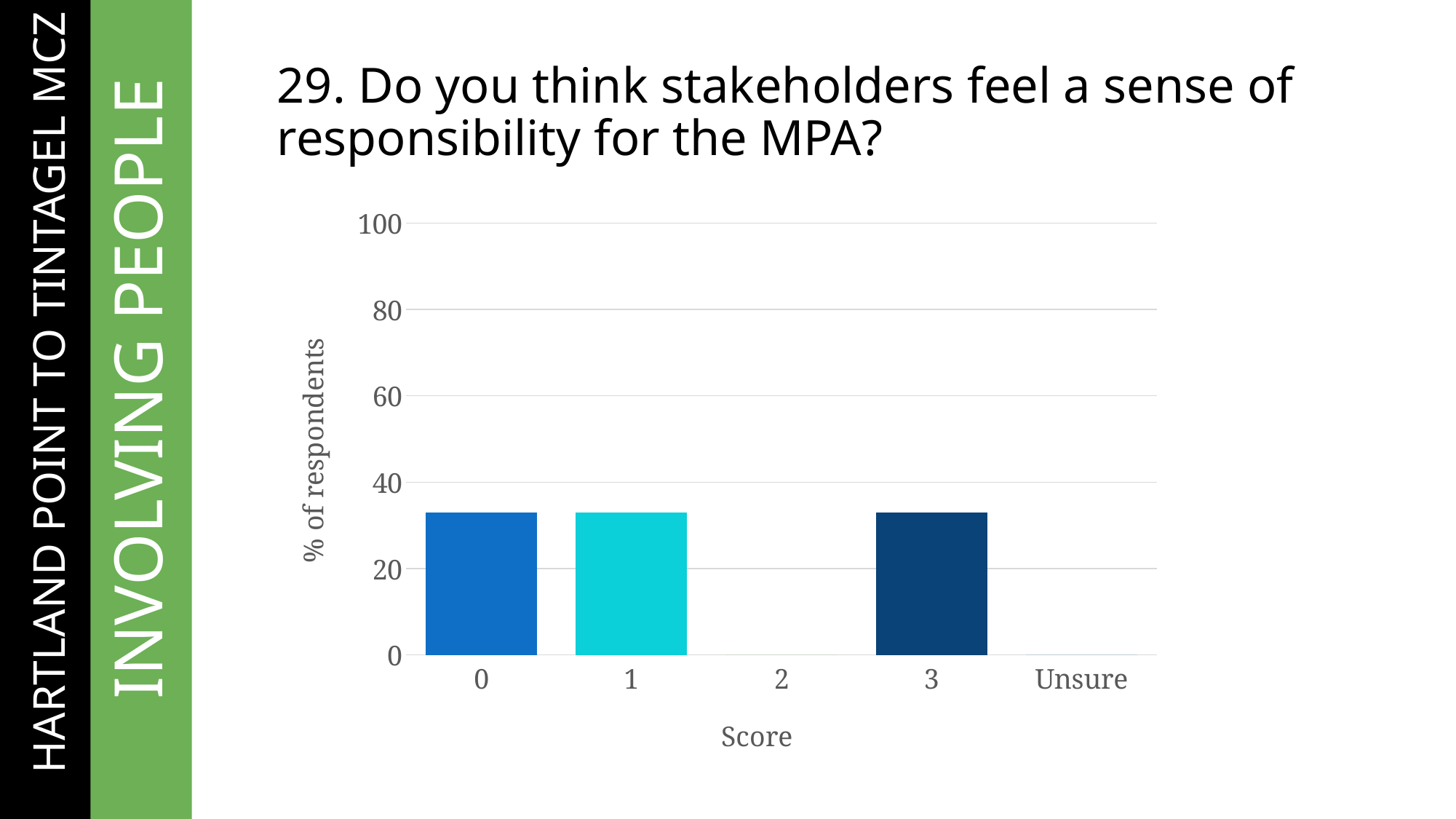
Is the value for score 0 greater or less than 20? greater How many categories are shown on the x axis of the chart? 5 What is the label of the y axis? % of respondents What is the value for score 2? 0 Is the value for score 3 greater or less than 20? greater Which is larger, the value for score 3 or the value for Unsure? score 3 Is the value for score 3 greater or less than 40? less What is the label of the x axis? Score What is the value for Unsure? 0 Which is larger, the value for score 0 or the value for score 2? score 0 What kind of chart is shown on the slide? bar chart